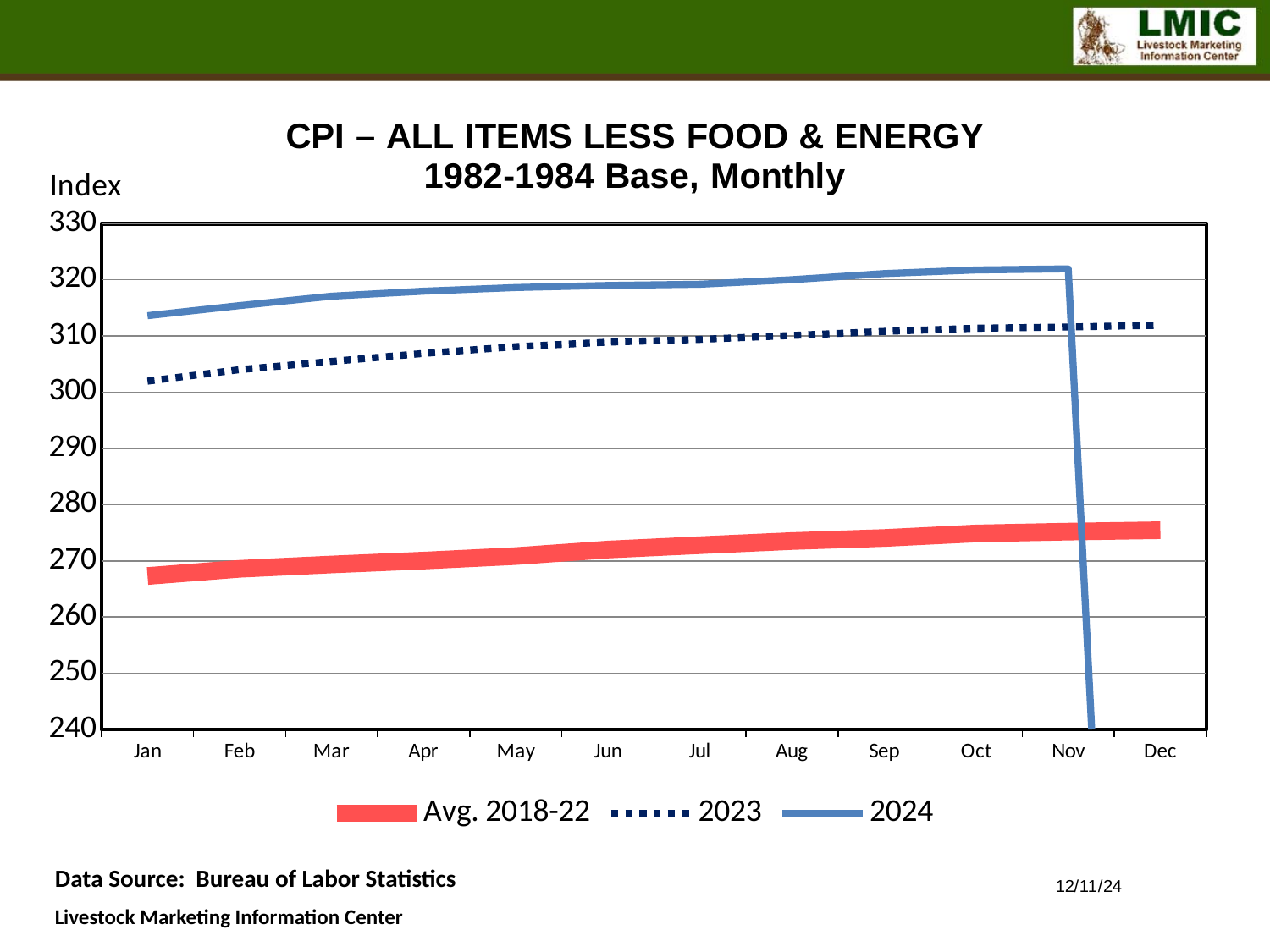
Is the value for Avg. 2018-22 in Jan greater or less than 270? less How many months are shown along the x axis? 12 Is the value for 2023 in Jun greater or less than 300? greater Is the value for Avg. 2018-22 in Dec greater or less than 270? greater Which series has the lowest values across the year? Avg. 2018-22 In Jan, which is larger: the 2024 value or the 2023 value? 2024 Do the 2023 values rise or fall from Jan to Dec? rise What kind of chart is shown on the slide? line chart How many series does the legend list? 3 What is the title of the chart? CPI – ALL ITEMS LESS FOOD & ENERGY 1982-1984 Base, Monthly